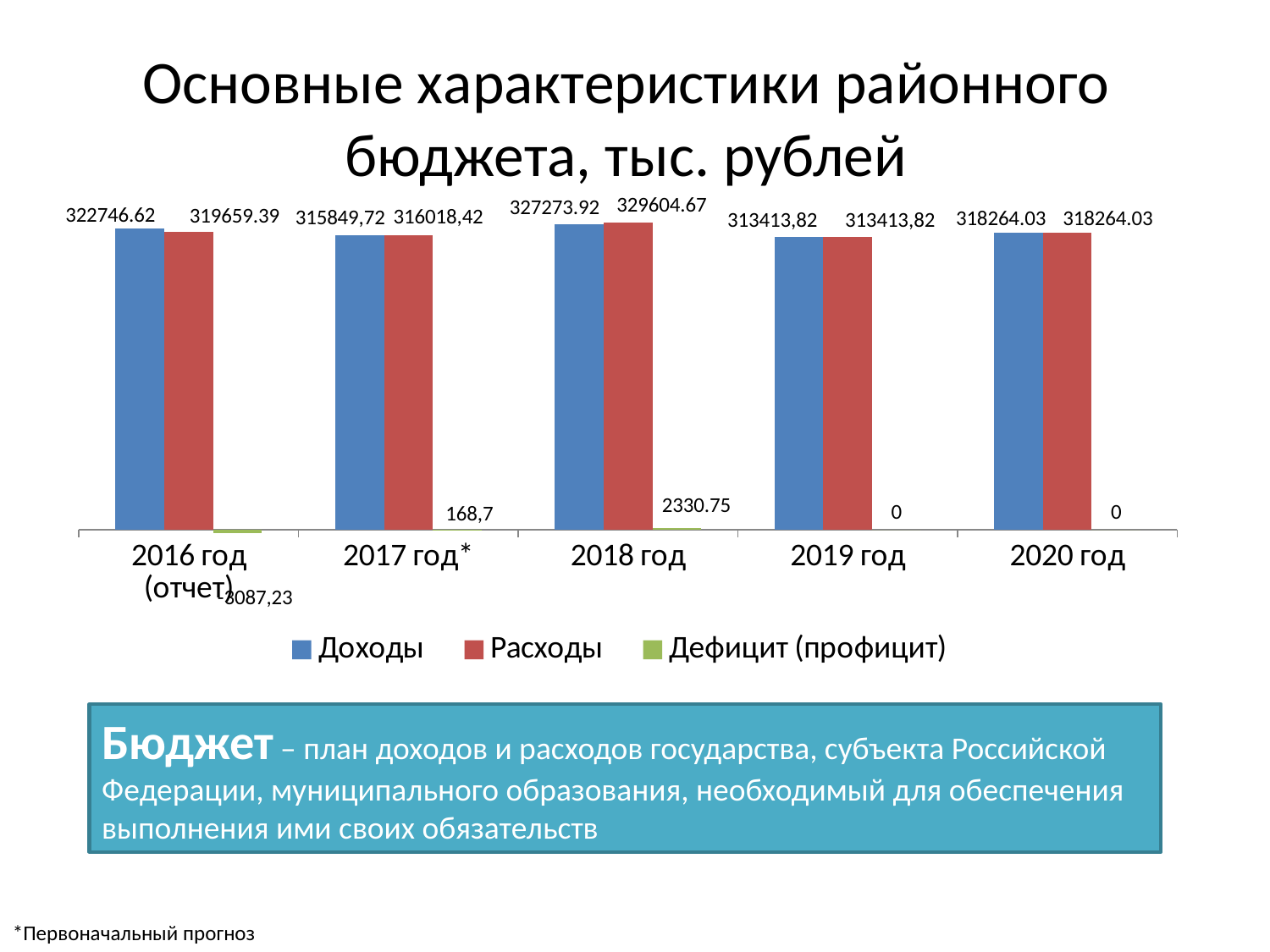
What kind of chart is shown on the slide? Bar chart What is the value of Доходы for 2016 год (отчет)? 322746.62 In which year is Доходы the lowest? 2019 год What is the value of Расходы for 2018 год? 329604.67 What is the difference between Расходы and Доходы for 2018 год? 2330.75 How many years (categories) are shown on the x axis? 5 What is the value of Дефицит (профицит) for 2017 год*? 168,7 What is the value of Дефицит (профицит) for 2019 год? 0 For 2016 год (отчет), which is larger: Доходы or Расходы? Доходы What is the value of Расходы for 2020 год? 318264.03 How many series does the legend list? 3 In which year is Доходы the highest? 2018 год